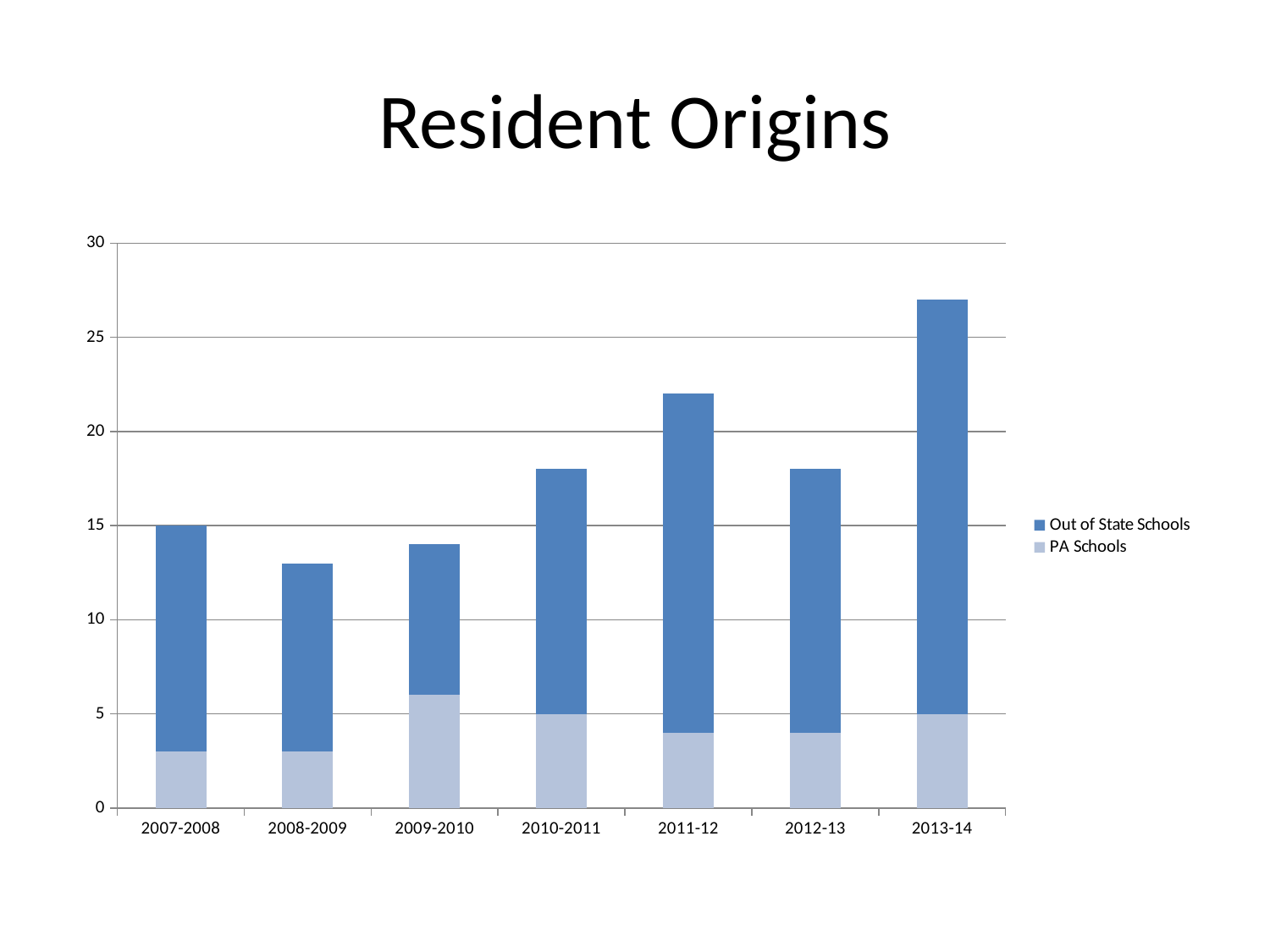
Is the PA Schools value for 2009-2010 greater or less than 5? greater Which academic year has the shortest stacked bar? 2008-2009 What is the total height of the stacked bar for 2007-2008? 15 Is the total for 2008-2009 greater or less than 15? less What are the two series named in the legend? Out of State Schools and PA Schools Is the total for 2013-14 greater or less than 25? greater How many academic years are shown on the x axis? 7 Which academic year has the tallest stacked bar? 2013-14 Which has the larger total, 2011-12 or 2012-13? 2011-12 How many series does the legend list? 2 What kind of chart is shown on the slide? bar chart